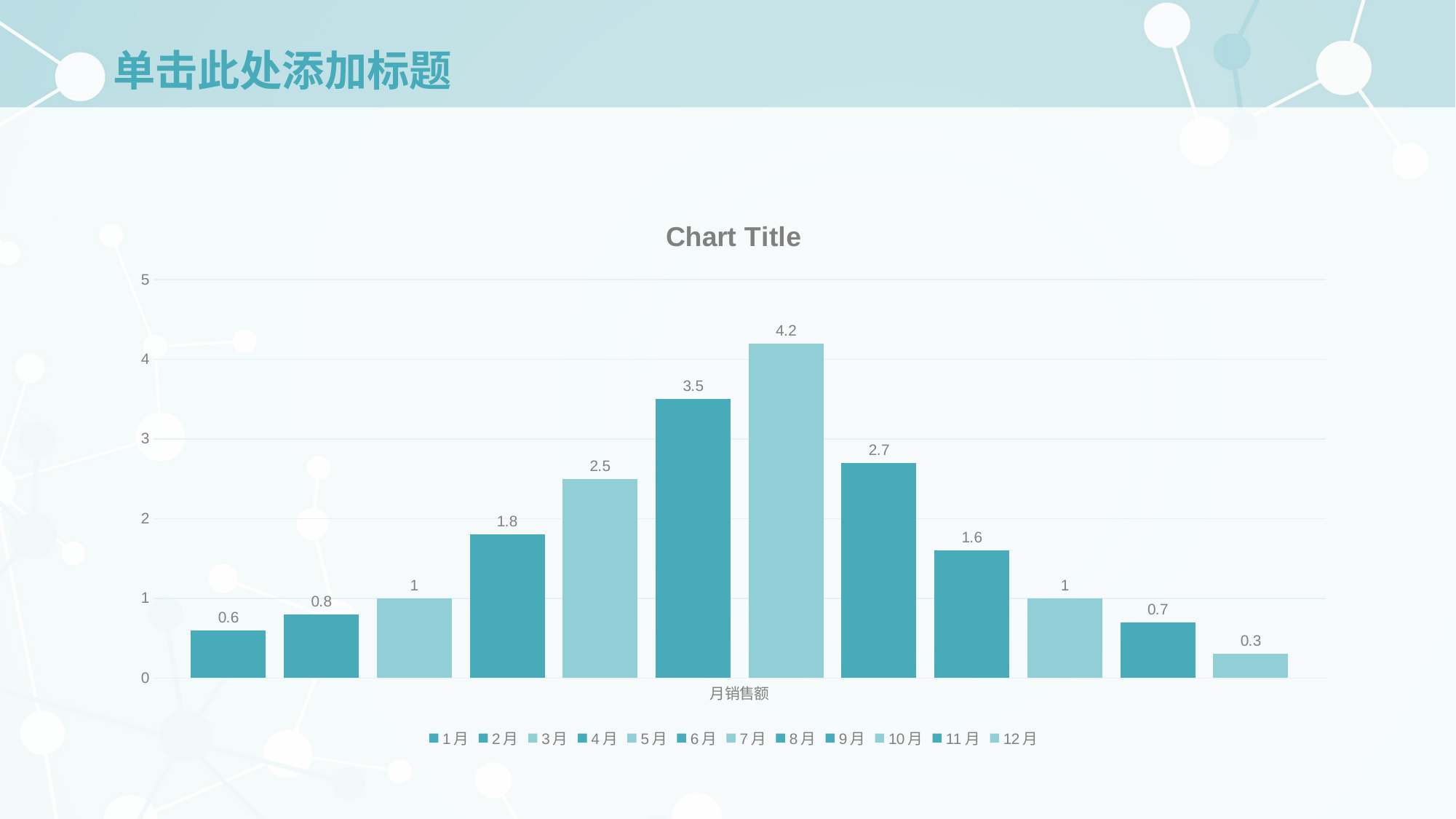
What is the difference between the values for 8月 and 4月? 0.9 How many series does the legend list? 12 What is the value for 1月 in the chart? 0.6 Which month has the lowest value in the chart? 12月 Which is larger, the value for 5月 or the value for 8月? 8月 What is the title of the chart? Chart Title Is the value for 6月 greater or less than 3? greater What is the value for 7月 in the chart? 4.2 Which month has the highest value in the chart? 7月 What is the difference between the values for 7月 and 6月? 0.7 What kind of chart is shown on the slide? Bar chart What is the value for 9月 in the chart? 1.6